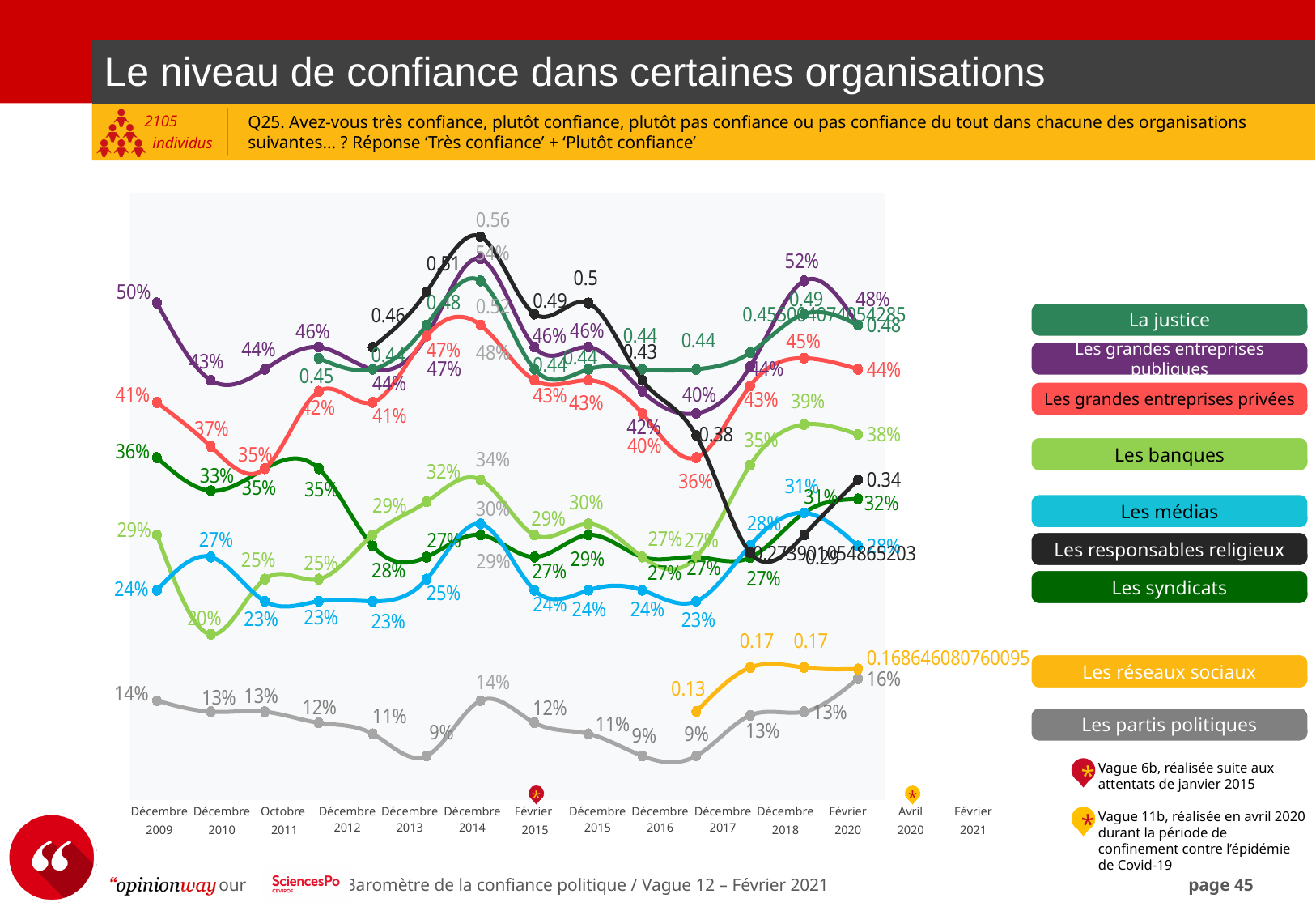
What is the value for Les médias in Décembre 2009? 24% In Décembre 2009, what is the difference between Les syndicats (36%) and Les médias (24%)? 12 points What is the value for Les partis politiques in Décembre 2009? 14% In Décembre 2009, which is higher: Les grandes entreprises publiques or Les grandes entreprises privées? Les grandes entreprises publiques How many dates are shown along the x axis? 14 What kind of chart is shown on the slide? Line chart What is the highest value reached by Les responsables religieux? 0.56 What is the value for Les grandes entreprises publiques in Décembre 2009? 50% What is the value for Les réseaux sociaux in Décembre 2018? 0.13 What is the lowest value reached by Les banques? 20% What is the value for Les partis politiques in Février 2021? 16% How many series does the legend list? 9